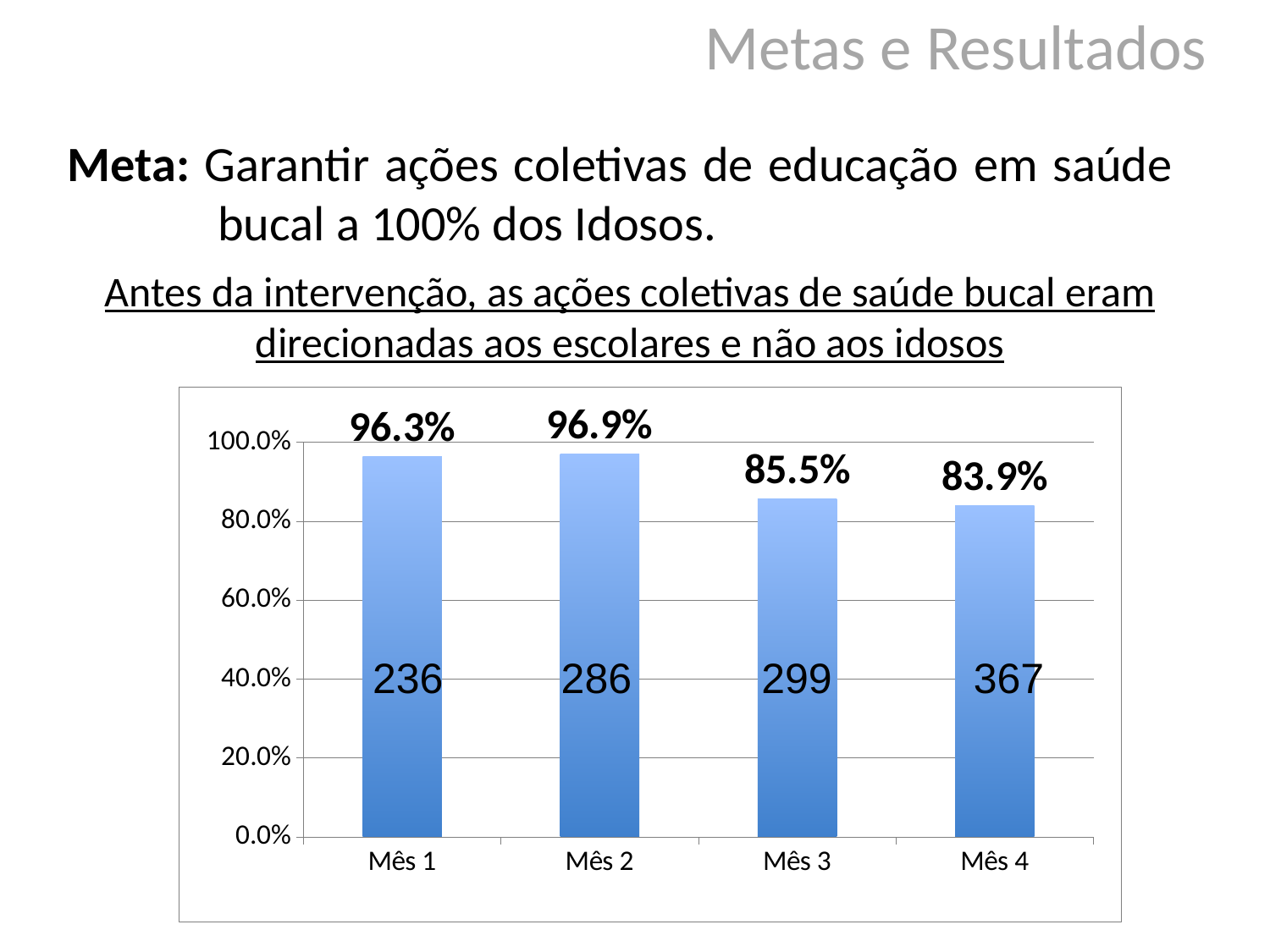
Do the percentages rise or fall from Mês 2 to Mês 4? fall What percentage is shown for Mês 3? 85.5% What percentage is shown for Mês 1? 96.3% What number is printed inside the bar for Mês 4? 367 Which month has the lowest percentage? Mês 4 How many months are shown on the x axis? 4 What kind of chart is shown on the slide? bar chart Which month has the highest percentage? Mês 2 Which has a higher percentage, Mês 1 or Mês 3? Mês 1 Is the value for Mês 3 greater or less than 80.0%? greater What is the difference in percentage between Mês 2 and Mês 4? 13.0% What number is printed inside the bar for Mês 2? 286